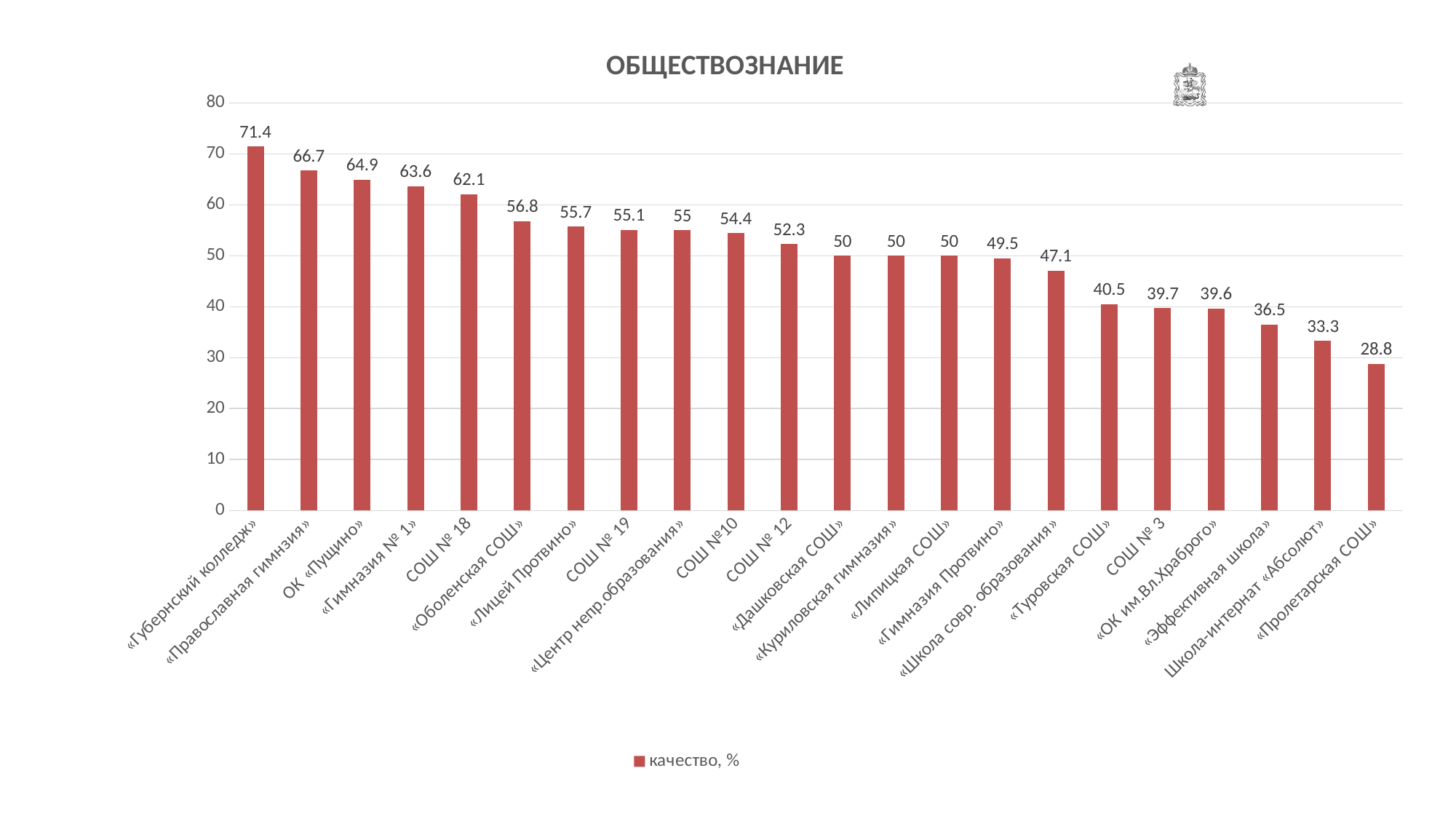
How many categories are shown on the chart? 22 Which category has the highest value? «Губернский колледж» What kind of chart is shown? bar chart What is the value for «Туровская СОШ»? 40.5 What is the difference between the values for «Губернский колледж» and «Пролетарская СОШ»? 42.6 Is the value for «Эффективная школа» greater or less than 40? less How many series does the legend list? 1 What is the title of the chart? ОБЩЕСТВОЗНАНИЕ What is the value for «Губернский колледж»? 71.4 Which is larger, the value for СОШ № 18 or the value for «Оболенская СОШ»? СОШ № 18 Which category has the lowest value? «Пролетарская СОШ» What is the value for «Лицей Протвино»? 55.7